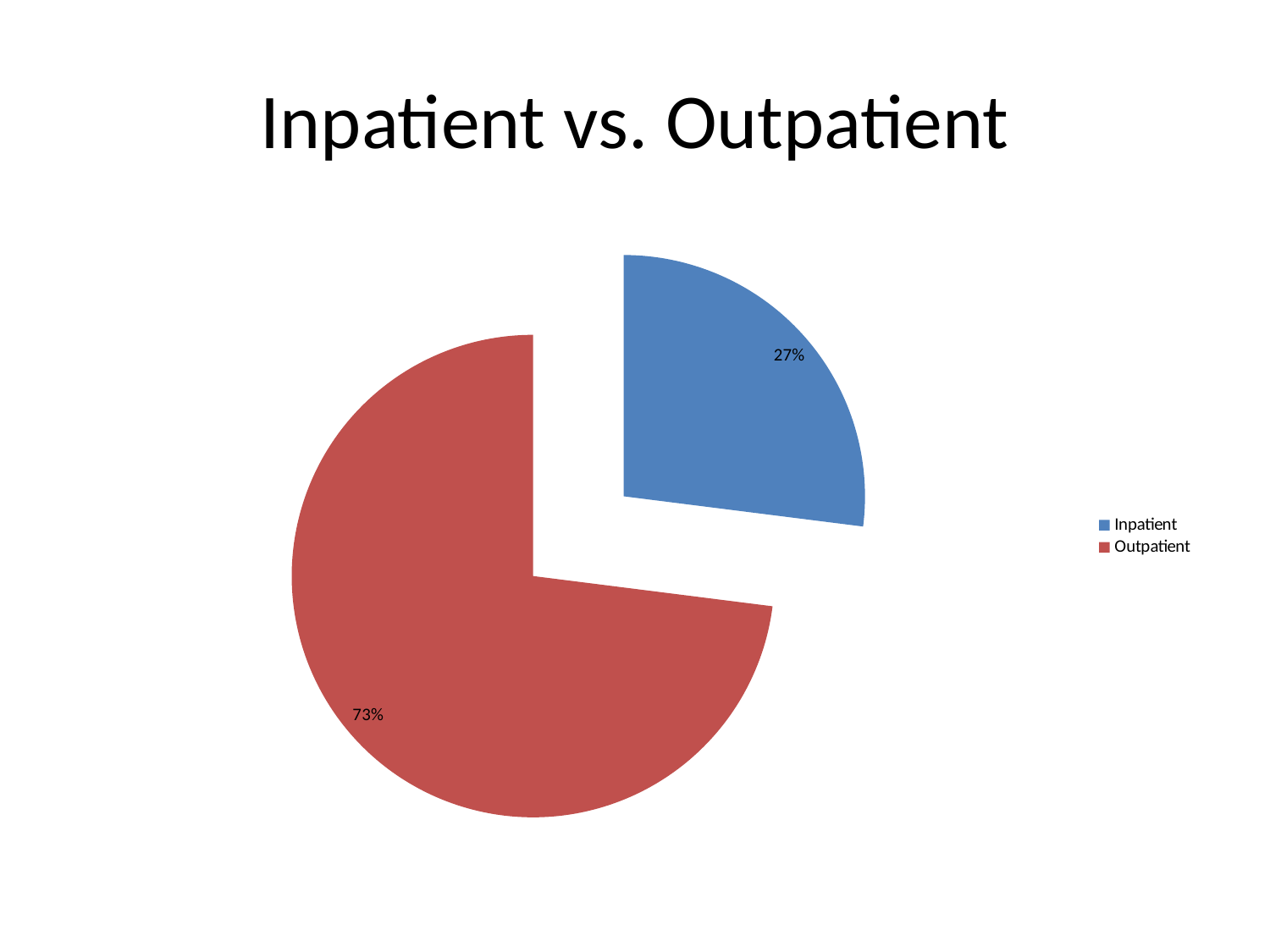
What kind of chart is shown on the slide? Pie chart Which category has the largest slice of the pie? Outpatient How many entries does the legend list? 2 Which category has the smallest slice of the pie? Inpatient What share of the pie does Outpatient represent? 73% What is the difference in percentage points between the Outpatient and Inpatient slices? 46 How many categories are shown in the pie chart? 2 What colour is the Inpatient slice? Blue Which is larger, the Inpatient slice or the Outpatient slice? Outpatient What share of the pie does Inpatient represent? 27% What is the title of the slide? Inpatient vs. Outpatient